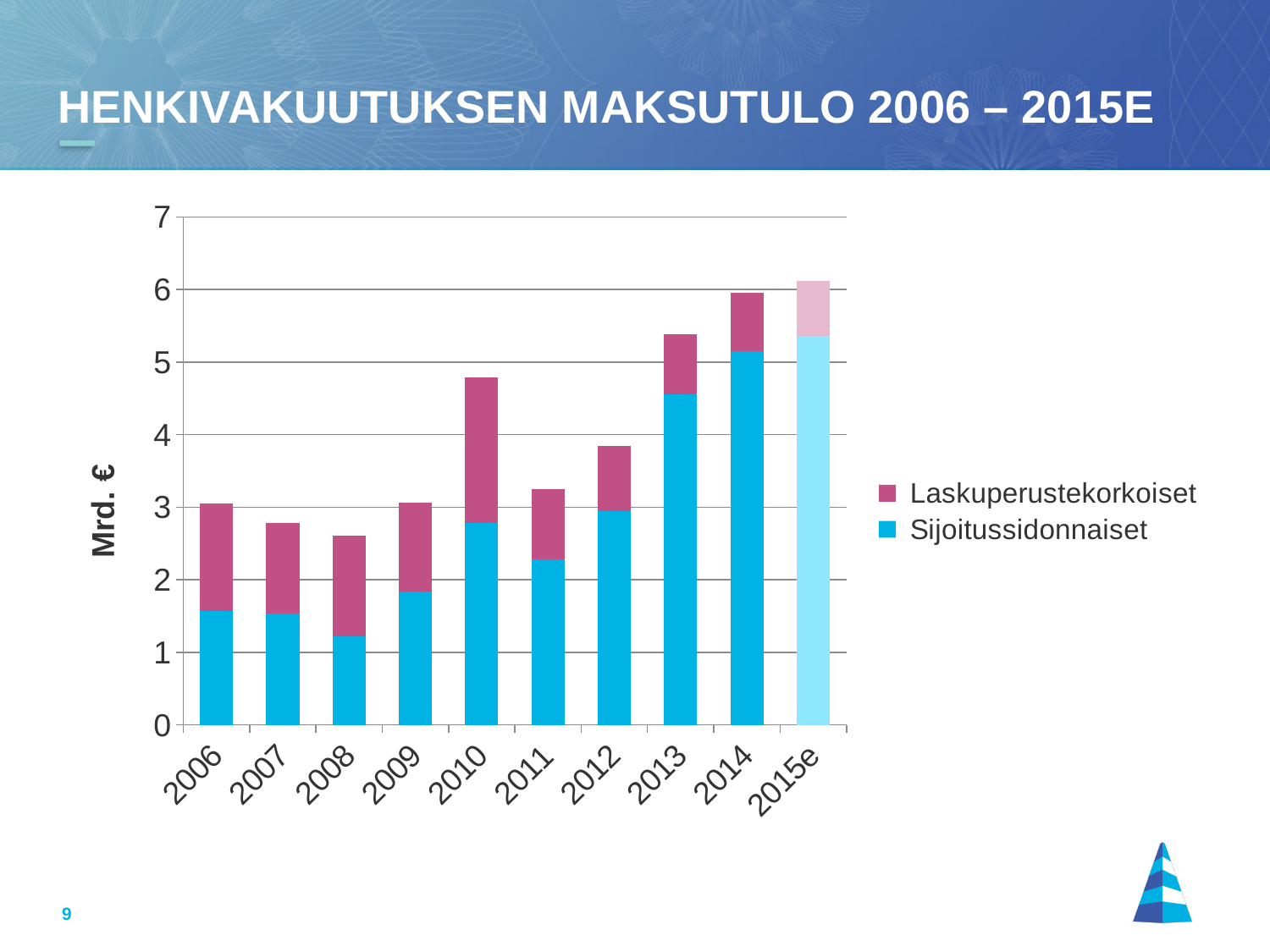
What is the label on the vertical axis? Mrd. € Which series is shown in the pink/magenta colour? Laskuperustekorkoiset Is the total value for 2010 greater or less than 4? greater How many series does the legend list? 2 What kind of chart is shown on the slide? Stacked bar chart Which year has the lowest total bar? 2008 Which year has the larger total bar, 2011 or 2012? 2012 How many years (categories) are shown on the x axis? 10 Do the total bars rise or fall from 2012 to 2015e? rise Which year has the highest total bar? 2015e Is the Sijoitussidonnaiset value for 2013 greater or less than 4? greater Is the total value for 2008 greater or less than 3? less